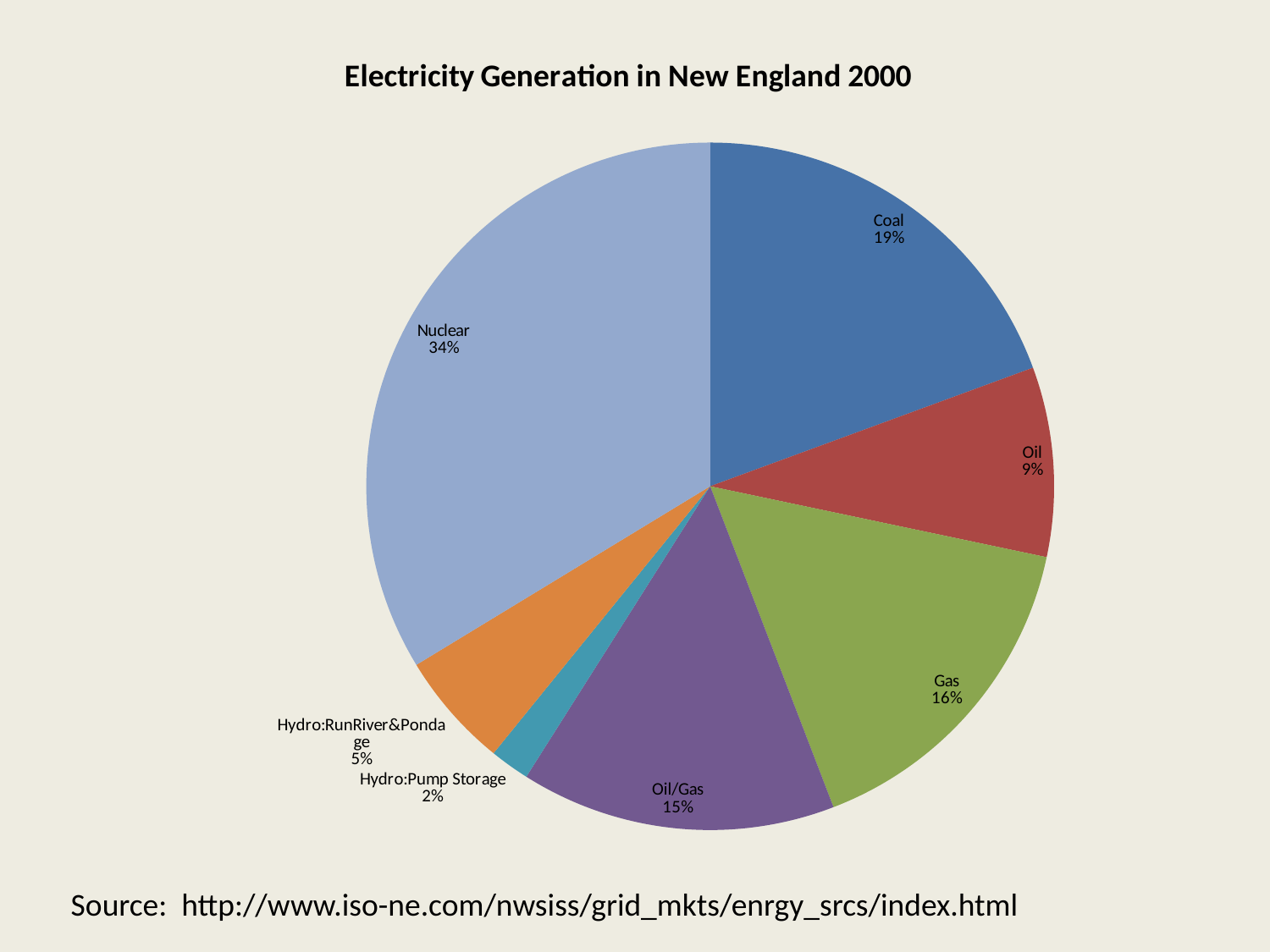
What share of electricity generation does Nuclear account for? 34% What is the share for Gas? 16% What percentage of electricity generation comes from Coal? 19% What type of chart is shown on the slide? Pie chart What percentage is shown for Hydro:Pump Storage? 2% Which energy source has the smallest share of electricity generation? Hydro:Pump Storage Which has a larger share, Coal or Oil? Coal What is the difference in percentage points between Gas and Oil/Gas? 1 What is the title of the chart? Electricity Generation in New England 2000 How many percentage points larger is the Nuclear share than the Coal share? 15 How many energy sources are shown in the pie chart? 7 Which energy source has the largest share of electricity generation? Nuclear